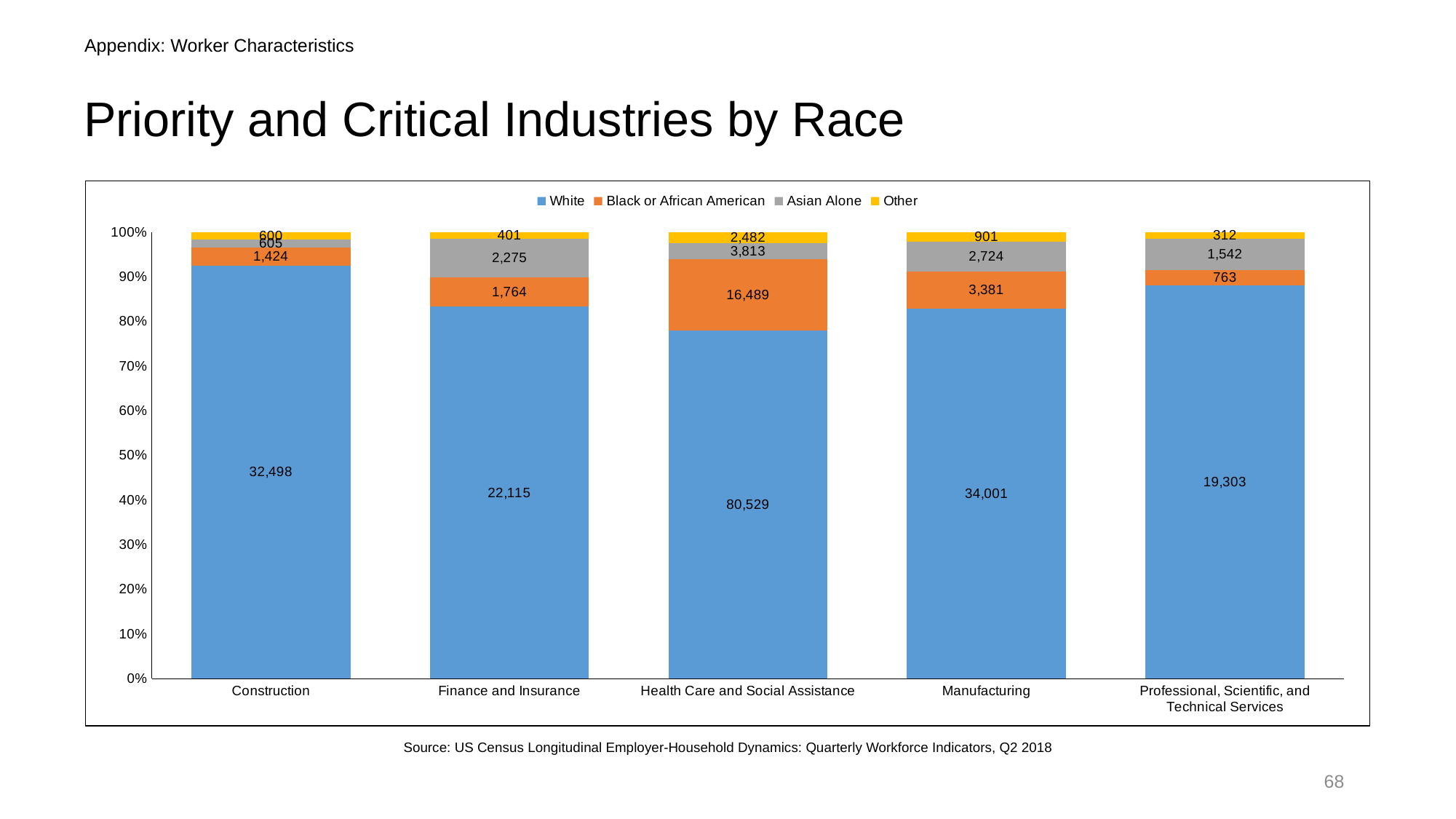
What is the value for Black or African American in Manufacturing? 3,381 How many industries are shown on the x axis? 5 What is the value for Asian Alone in Finance and Insurance? 2,275 Which industry has the highest value for White? Health Care and Social Assistance What is the total of all segments in the Manufacturing bar? 41,007 What is the value for Other in Professional, Scientific, and Technical Services? 312 What is the difference between the Black or African American values for Health Care and Social Assistance and Manufacturing? 13,108 How many series does the legend list? 4 Which industry has the lowest value for Black or African American? Professional, Scientific, and Technical Services Which is larger, the Asian Alone value for Manufacturing or for Finance and Insurance? Manufacturing What is the value for White in Health Care and Social Assistance? 80,529 Is the White share of the Health Care and Social Assistance bar greater or less than 80%? less